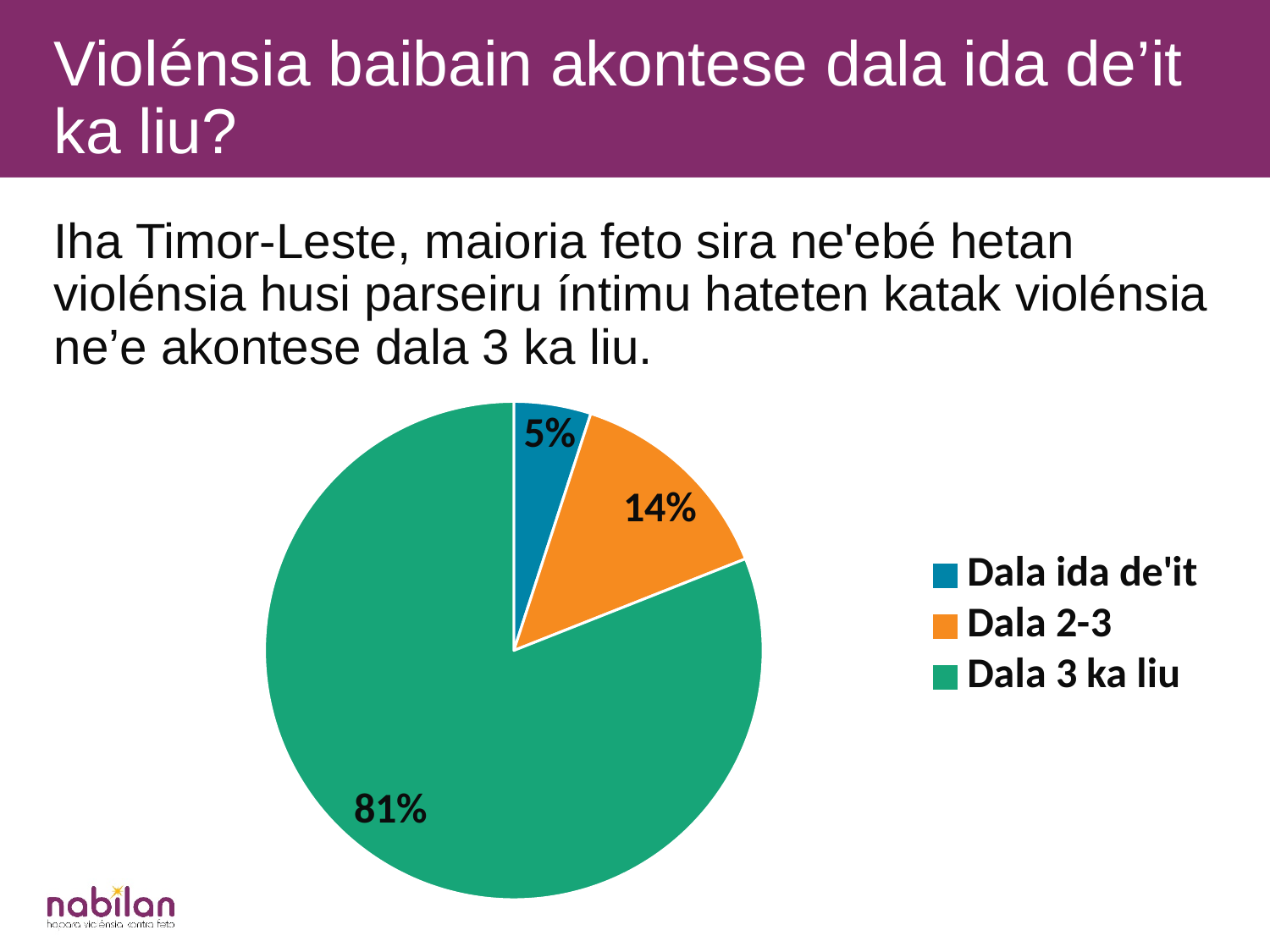
How many categories does the pie chart show? 3 What is the combined share of "Dala ida de'it" and "Dala 2-3"? 19% What is the difference in percentage points between "Dala 3 ka liu" and "Dala 2-3"? 67 What kind of chart is shown on the slide? Pie chart What colour is the slice for "Dala 2-3"? Orange Which category has the smallest slice of the pie? Dala ida de'it What percentage of the pie is labelled for "Dala 2-3"? 14% What is the difference in percentage points between "Dala 2-3" and "Dala ida de'it"? 9 What percentage of the pie is labelled for "Dala ida de'it"? 5% Which category has the largest slice of the pie? Dala 3 ka liu What percentage of the pie is labelled for "Dala 3 ka liu"? 81% Which is larger, the slice for "Dala 2-3" or the slice for "Dala ida de'it"? Dala 2-3